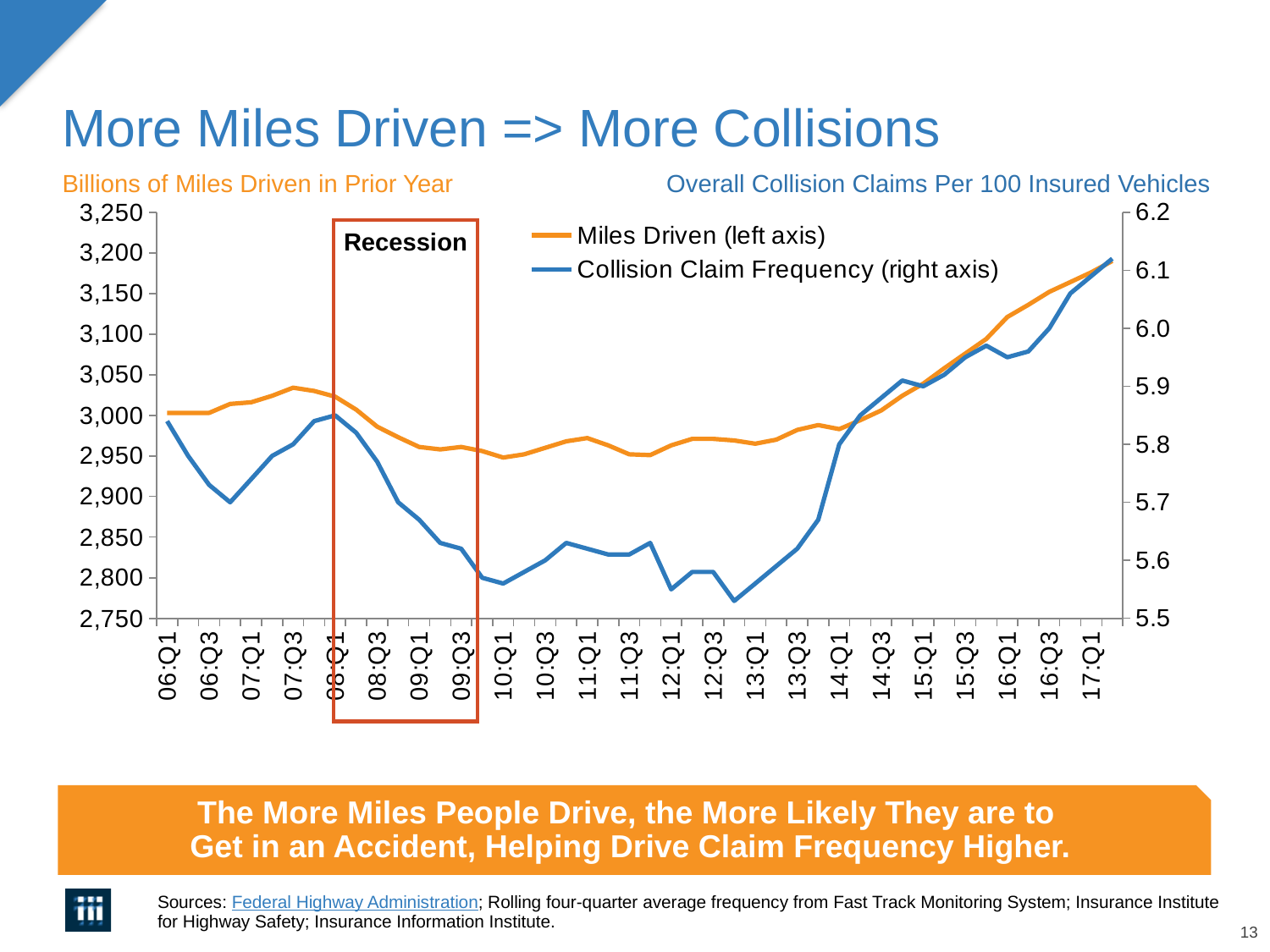
Is the value for Miles Driven at 07:Q3 greater or less than 3,000? greater Is the value for Collision Claim Frequency at 17:Q1 greater or less than 6.0? greater What kind of chart is shown on the slide? line chart How many series does the legend list? 2 Is the value for Miles Driven at 10:Q1 greater or less than 3,000? less Which is larger, Miles Driven at 07:Q3 or Miles Driven at 10:Q1? 07:Q3 Does Collision Claim Frequency rise or fall from 14:Q1 to 17:Q1? rise Which series is plotted against the right axis? Collision Claim Frequency What period is marked by the red box on the chart? Recession